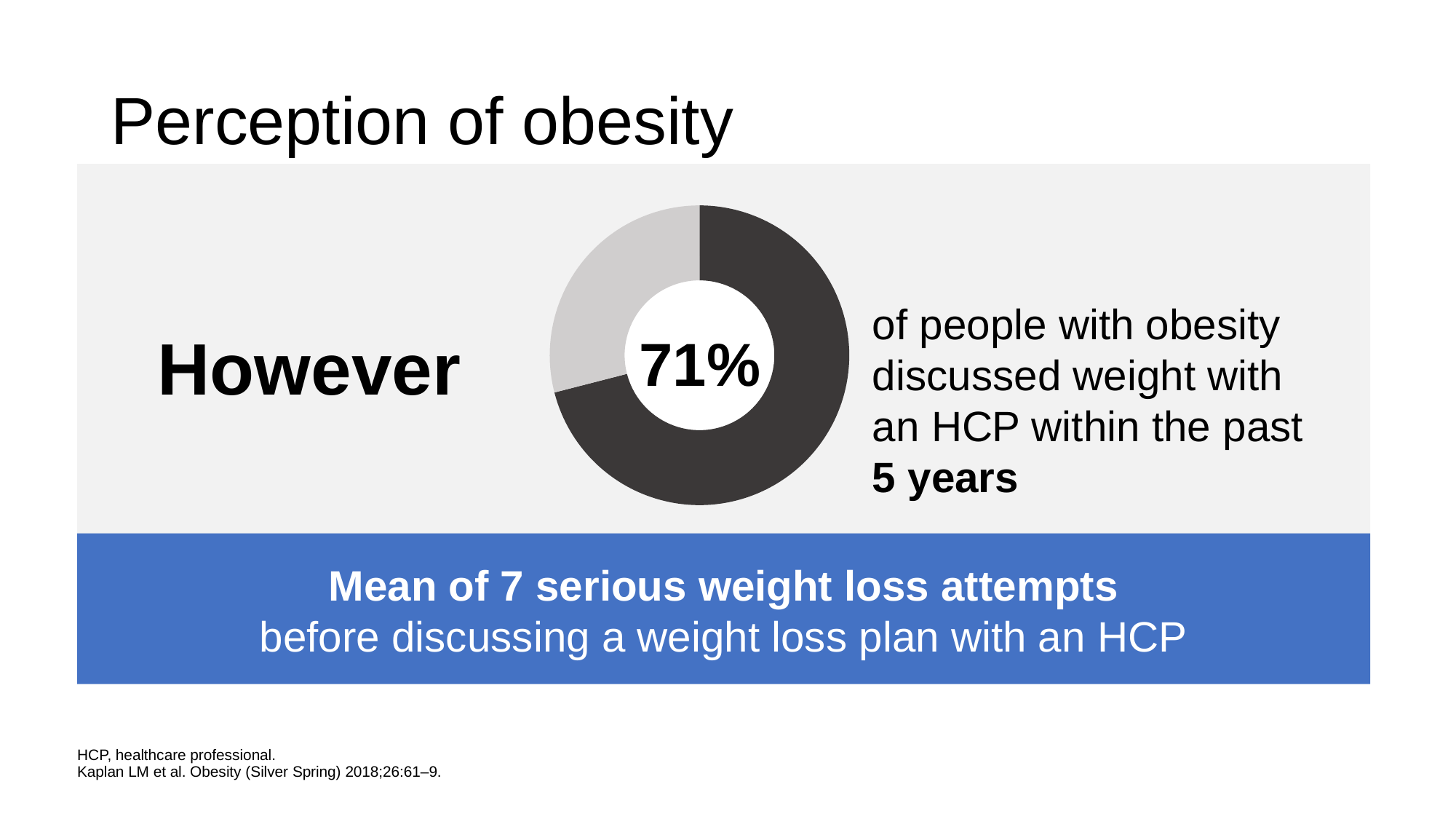
What share of people with obesity discussed weight with an HCP within the past 5 years, according to the donut chart? 71% How many segments does the donut chart have? 2 What percentage is printed in the centre of the donut chart? 71% Which segment of the donut chart represents the 71% value? The dark grey segment Over what time period did 71% of people with obesity discuss weight with an HCP, according to the text next to the donut chart? The past 5 years Is the dark grey segment of the donut chart greater or less than 50% of the whole? greater What kind of chart is shown on the slide? Donut (pie) chart Which segment of the donut chart is larger, the dark grey one or the light grey one? The dark grey one Is the light grey segment of the donut chart greater or less than 50% of the whole? less